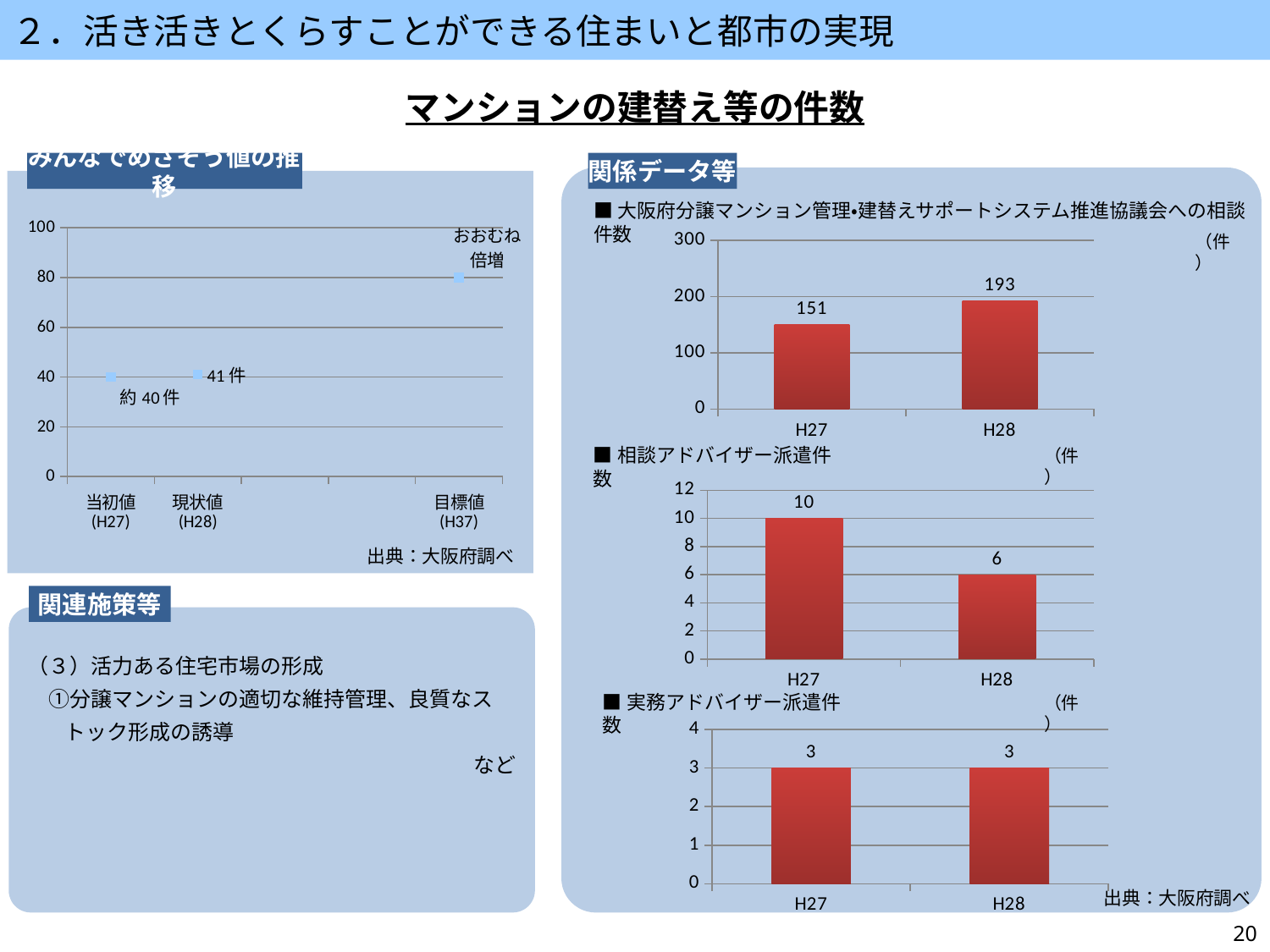
How many categories are shown on the x axis of the chart titled 大阪府分譲マンション管理・建替えサポートシステム推進協議会への相談件数? 2 In the chart titled 大阪府分譲マンション管理・建替えサポートシステム推進協議会への相談件数, what is the value for H27? 151 In the chart titled みんなでめざそう値の推移, is the value for 目標値 (H37) greater or less than 60? greater In the chart titled 大阪府分譲マンション管理・建替えサポートシステム推進協議会への相談件数, what is the difference between the H28 and H27 values? 42 In the chart titled 実務アドバイザー派遣件数, what is the value for H28? 3 In the chart titled 相談アドバイザー派遣件数, do the values rise or fall from H27 to H28? fall In the chart titled みんなでめざそう値の推移, what is the value labelled for 現状値 (H28)? 41件 In the chart titled 大阪府分譲マンション管理・建替えサポートシステム推進協議会への相談件数, what is the value for H28? 193 In the chart titled 相談アドバイザー派遣件数, which year has the lower value? H28 In the chart titled 相談アドバイザー派遣件数, what is the value for H27? 10 In the chart titled 実務アドバイザー派遣件数, what is the difference between the H27 and H28 values? 0 What kind of chart is the chart titled 相談アドバイザー派遣件数? bar chart